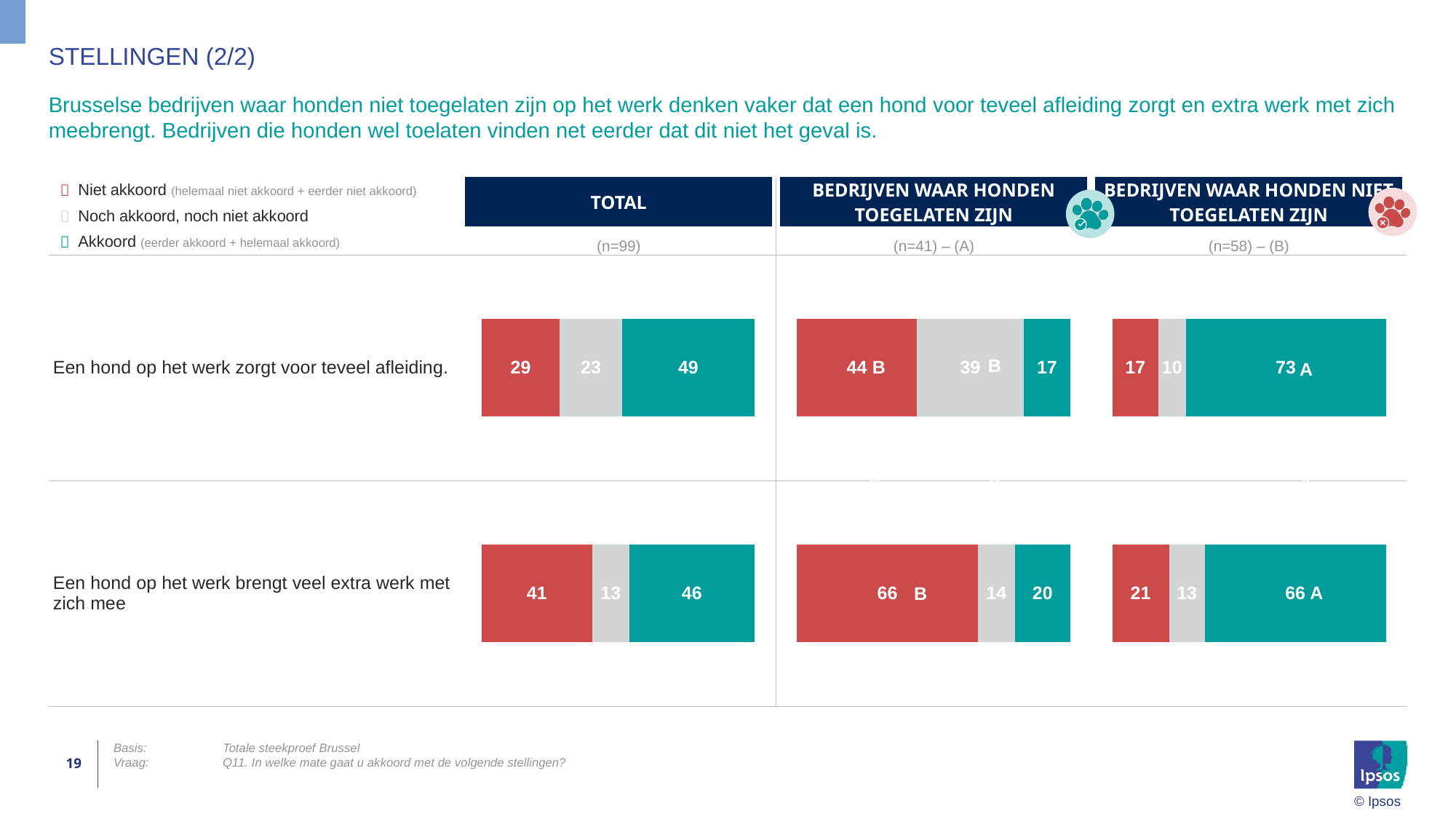
In the 'BEDRIJVEN WAAR HONDEN TOEGELATEN ZIJN' chart, what is the 'Niet akkoord' value for 'Een hond op het werk brengt veel extra werk met zich mee'? 66 In the 'BEDRIJVEN WAAR HONDEN NIET TOEGELATEN ZIJN' chart, which segment is largest for 'Een hond op het werk brengt veel extra werk met zich mee'? Akkoord What kind of chart is used on this slide? Stacked bar chart In the 'BEDRIJVEN WAAR HONDEN NIET TOEGELATEN ZIJN' chart, what is the 'Akkoord' value for 'Een hond op het werk zorgt voor teveel afleiding.'? 73 What is the difference between the 'Akkoord' value for 'Een hond op het werk zorgt voor teveel afleiding.' in the 'BEDRIJVEN WAAR HONDEN NIET TOEGELATEN ZIJN' chart and in the 'BEDRIJVEN WAAR HONDEN TOEGELATEN ZIJN' chart? 56 In the TOTAL chart, which segment is smallest for 'Een hond op het werk brengt veel extra werk met zich mee'? Noch akkoord, noch niet akkoord What is the sample size (n) shown for the TOTAL chart? (n=99) In the TOTAL chart, what is the 'Akkoord' value for 'Een hond op het werk zorgt voor teveel afleiding.'? 49 In the TOTAL chart, what is the 'Niet akkoord' value for 'Een hond op het werk brengt veel extra werk met zich mee'? 41 In the TOTAL chart, is the 'Niet akkoord' value larger for 'Een hond op het werk zorgt voor teveel afleiding.' or for 'Een hond op het werk brengt veel extra werk met zich mee'? Een hond op het werk brengt veel extra werk met zich mee In the 'BEDRIJVEN WAAR HONDEN TOEGELATEN ZIJN' chart, what is the 'Noch akkoord, noch niet akkoord' value for 'Een hond op het werk zorgt voor teveel afleiding.'? 39 How many series does the legend list? 3